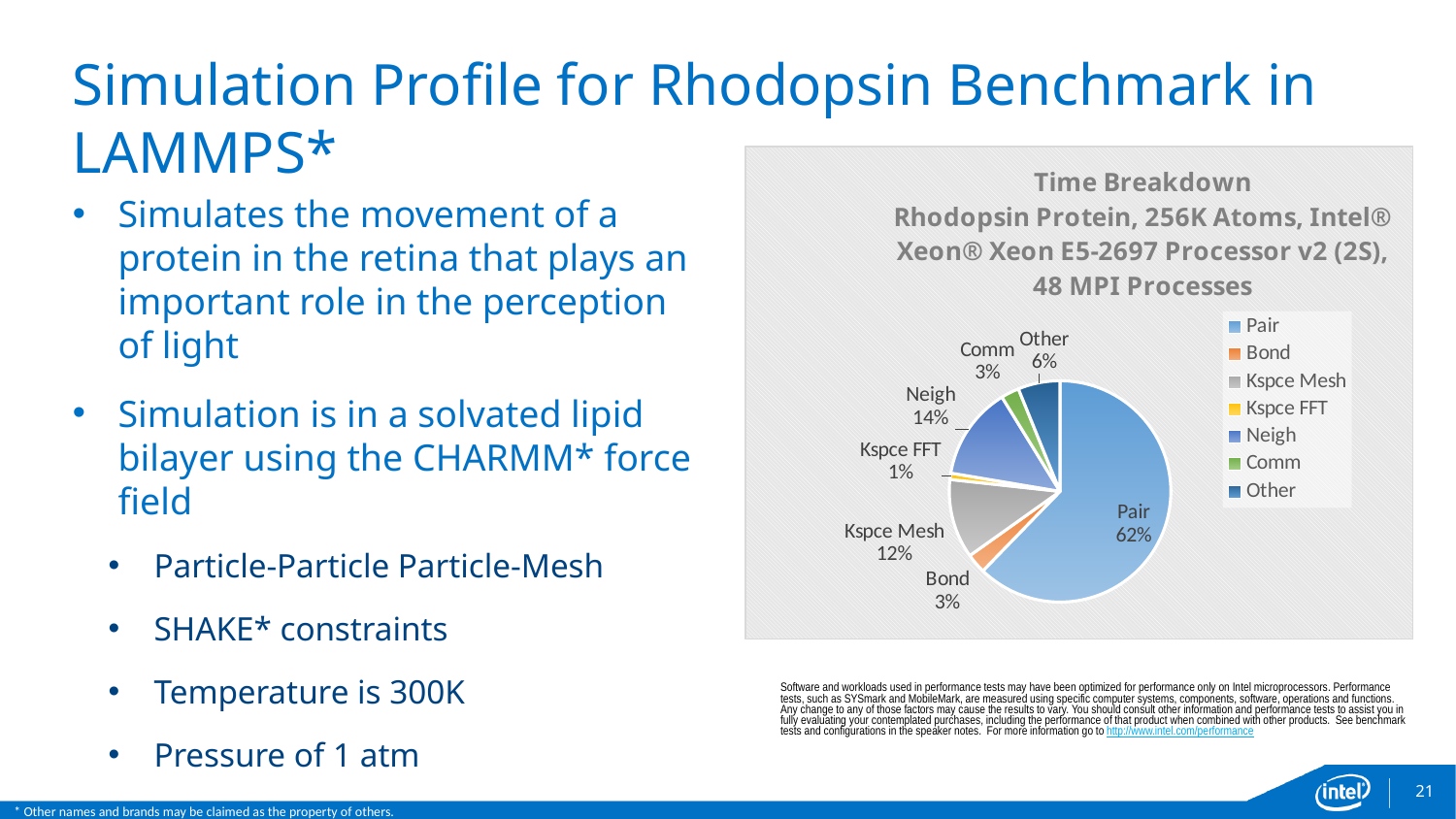
What is the combined share of Bond and Comm? 6% What share of time does Pair account for in the Time Breakdown pie chart? 62% What share of time does Kspce Mesh account for? 12% What is the difference in percentage points between the Pair share and the Neigh share? 48 Which category has the largest share of the pie? Pair What kind of chart is shown on the slide? pie chart How many MPI processes are stated in the chart title? 48 Which category has the smallest share of the pie? Kspce FFT What share of time does Neigh account for? 14% Which is larger, the share for Neigh or the share for Kspce Mesh? Neigh How many categories does the pie chart show? 7 What share of time does Kspce FFT account for? 1%